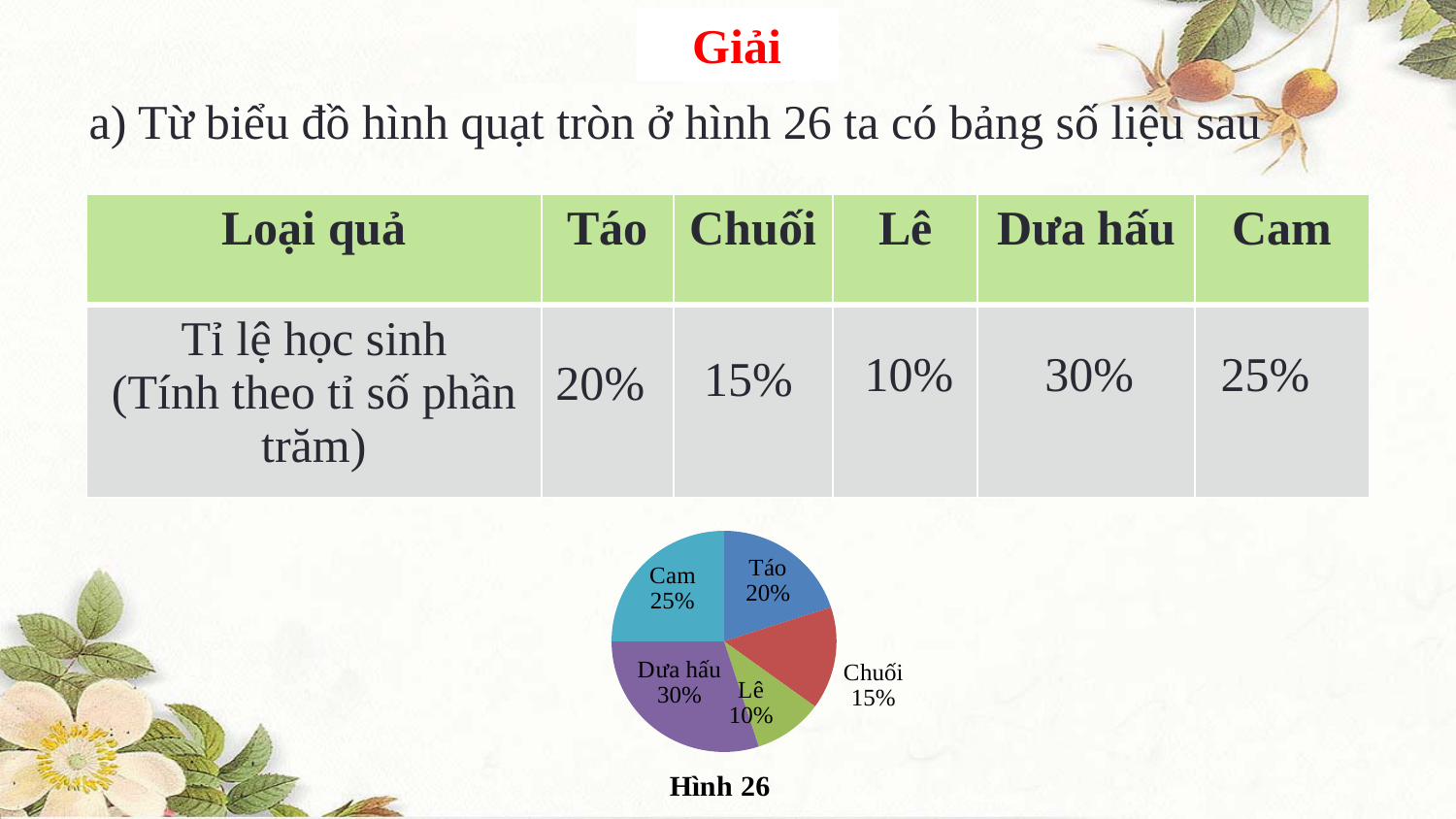
How many slices does the pie chart have? 5 What is the caption below the pie chart? Hình 26 Which fruit has the largest slice in the pie chart? Dưa hấu What kind of chart is shown in Hình 26? pie chart What is the difference in percentage points between the Cam slice and the Chuối slice? 10% What percentage does the Dưa hấu slice show in the pie chart? 30% What colour is the Dưa hấu slice in the pie chart? purple What percentage does the Táo slice show in the pie chart? 20% Which fruit has the smallest slice in the pie chart? Lê Which slice is larger in the pie chart, Cam or Táo? Cam What is the combined share of the Táo and Chuối slices? 35% What percentage does the Lê slice show in the pie chart? 10%